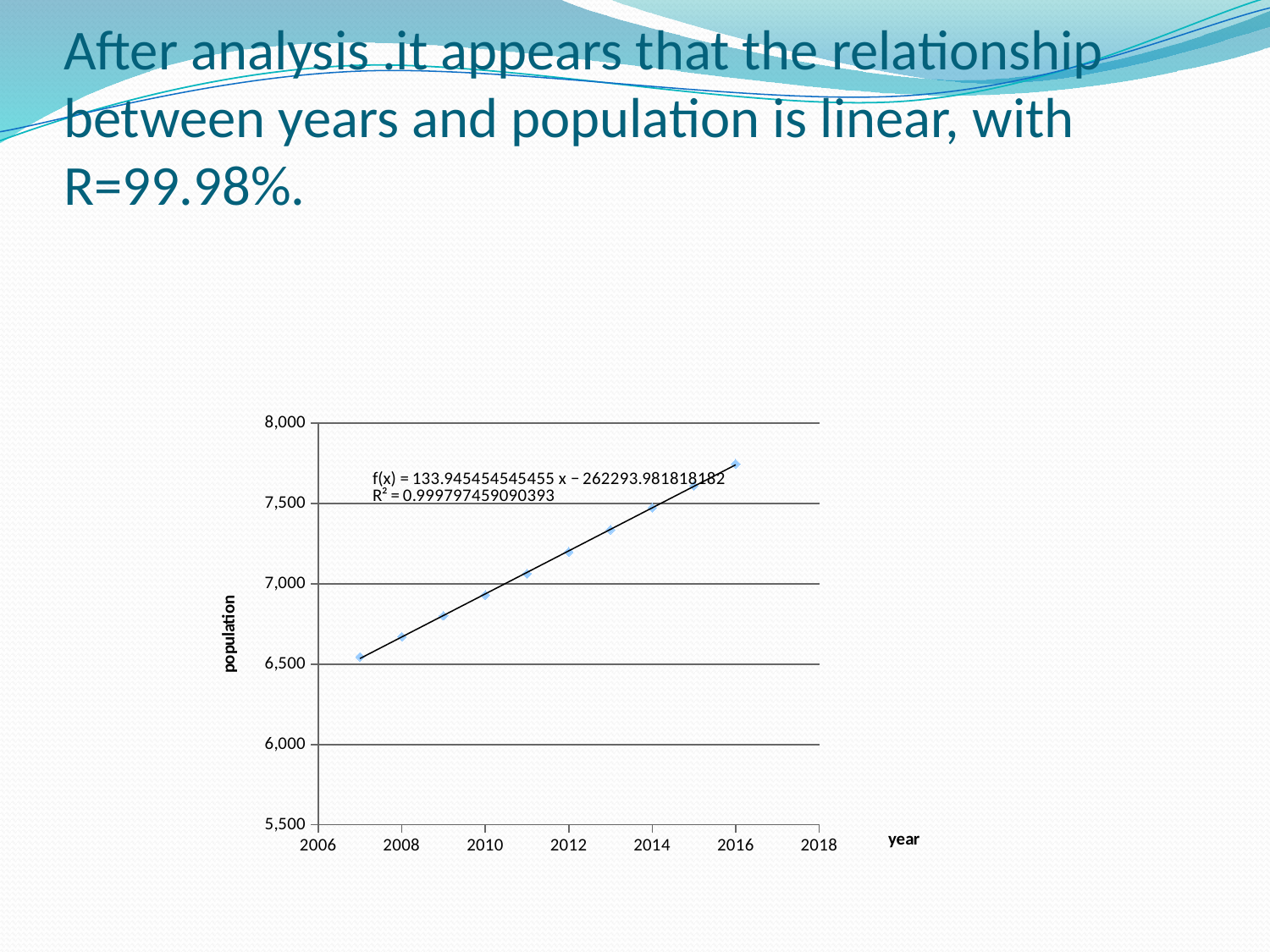
How many data points are plotted on the chart? 10 What is the label on the vertical axis of the chart? population Is the population value for 2012 greater or less than 7,000? greater Do the population values rise or fall as the year increases? rise Is the population value for 2007 greater or less than 7,000? less Which is larger, the population value for 2013 or for 2008? 2013 What R² value is printed on the chart? 0.999797459090393 Is the population value for 2016 greater or less than 7,500? greater Which year has the lowest population value on the chart? 2007 Which year has the highest population value on the chart? 2016 What kind of chart is shown on the slide? scatter chart